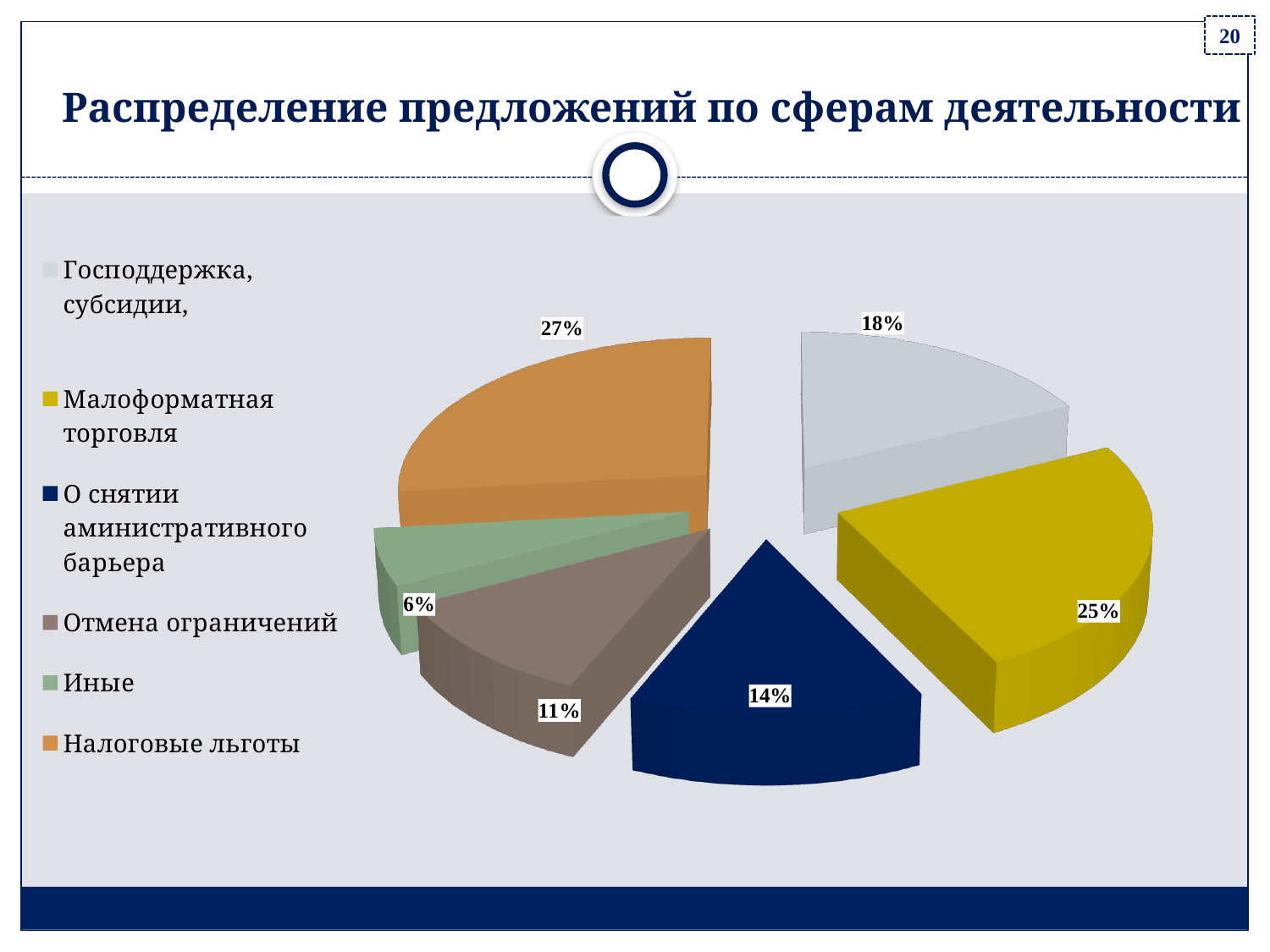
Which category has the smallest slice of the pie? Иные How many categories does the pie chart have? 6 What share of the pie does "Налоговые льготы" have? 27% What is the value shown for "Господдержка, субсидии"? 18% What is the value shown for "О снятии административного барьера"? 14% What kind of chart is shown on the slide? Pie chart What is the value shown for "Иные"? 6% Which is larger: the share for "Малоформатная торговля" or the share for "Господдержка, субсидии"? Малоформатная торговля Which category has the largest slice of the pie? Налоговые льготы What is the difference between the shares of "Налоговые льготы" and "Отмена ограничений"? 16% What is the title of the slide containing the chart? Распределение предложений по сферам деятельности What share of the pie does "Малоформатная торговля" have? 25%